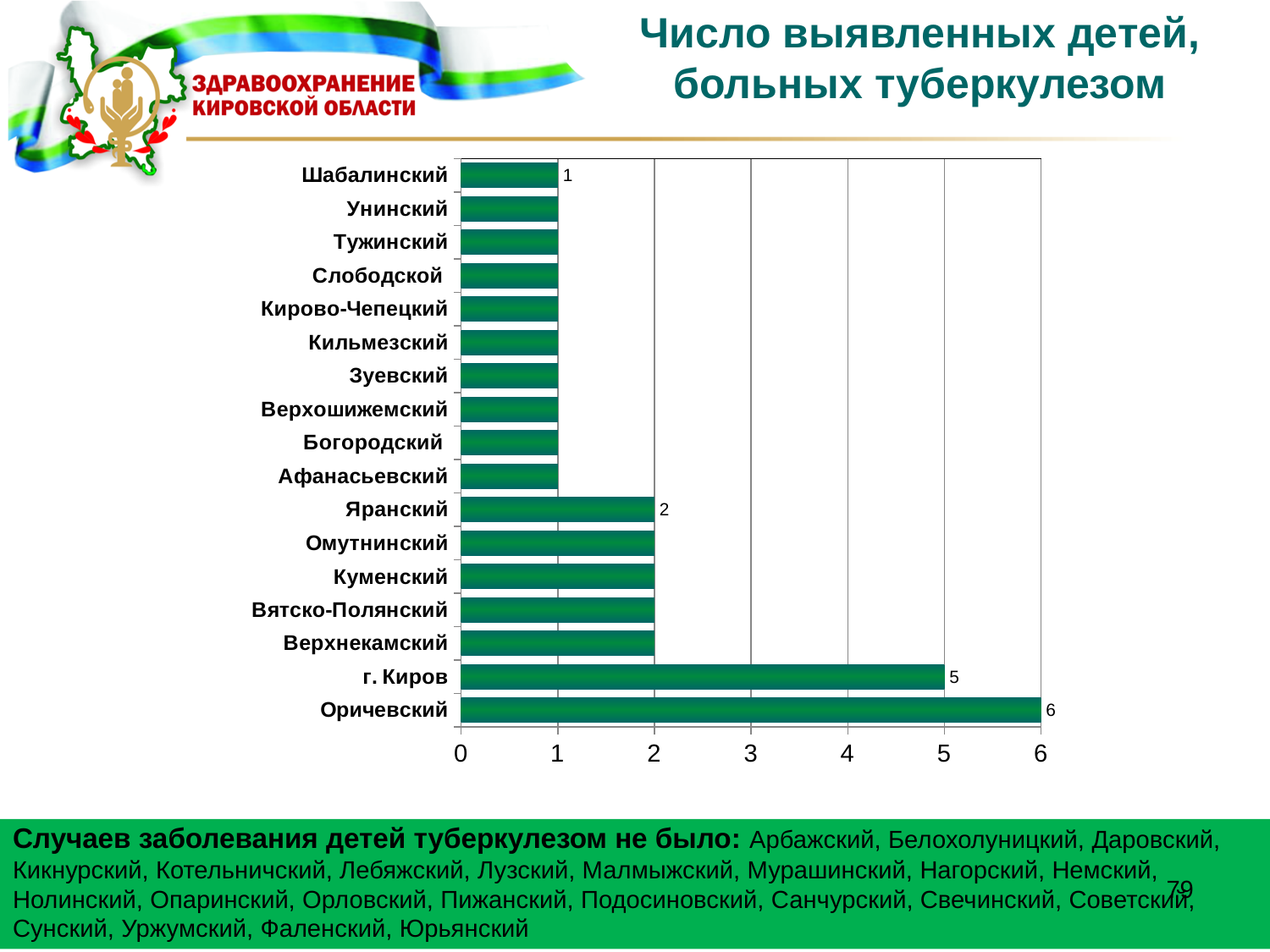
What is the difference between the values for г. Киров and Яранский? 3 What is the value for Яранский? 2 What is the difference between the values for Оричевский and г. Киров? 1 Is the value for Верхнекамский greater or less than 1? greater Which category has the highest value? Оричевский What is the value for Оричевский? 6 Which is larger, the value for г. Киров or the value for Яранский? г. Киров What type of chart is shown on the slide? bar chart How many categories are shown in the chart? 17 What is the value for г. Киров? 5 What is the title of the chart on the slide? Число выявленных детей, больных туберкулезом What is the value for Шабалинский? 1